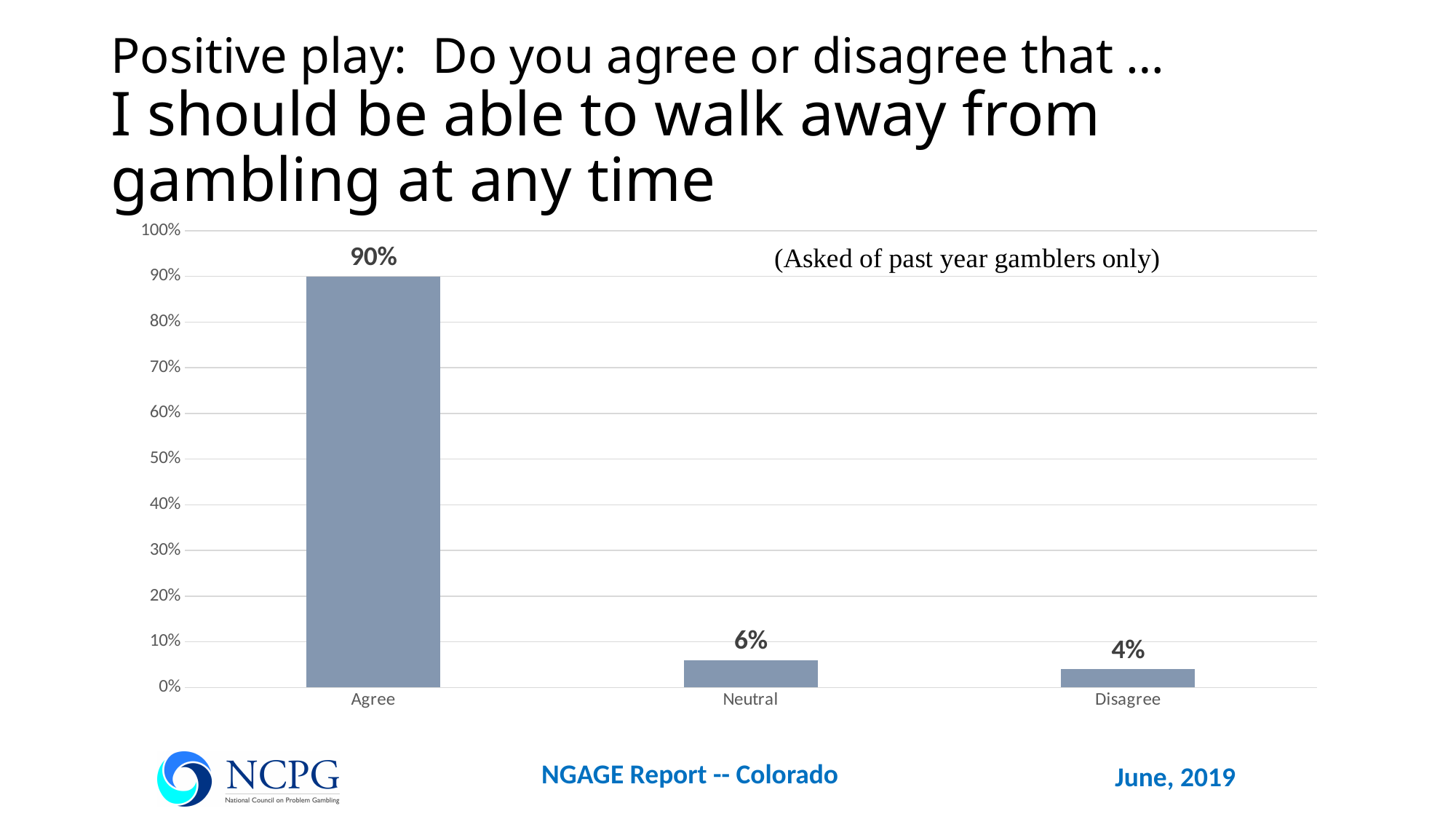
What kind of chart is shown on the slide? Bar chart How many categories are shown on the x axis? 3 Which category has the lowest value? Disagree What is the difference between the Agree and Disagree values? 86% What is the difference between the Neutral and Disagree values? 2% What percentage of respondents chose Agree? 90% According to the note on the chart, who was this question asked of? Past year gamblers only Is the value for Agree greater or less than 80%? greater Which is larger, the value for Neutral or the value for Disagree? Neutral Which category has the highest value? Agree What percentage of respondents chose Disagree? 4% What percentage of respondents chose Neutral? 6%